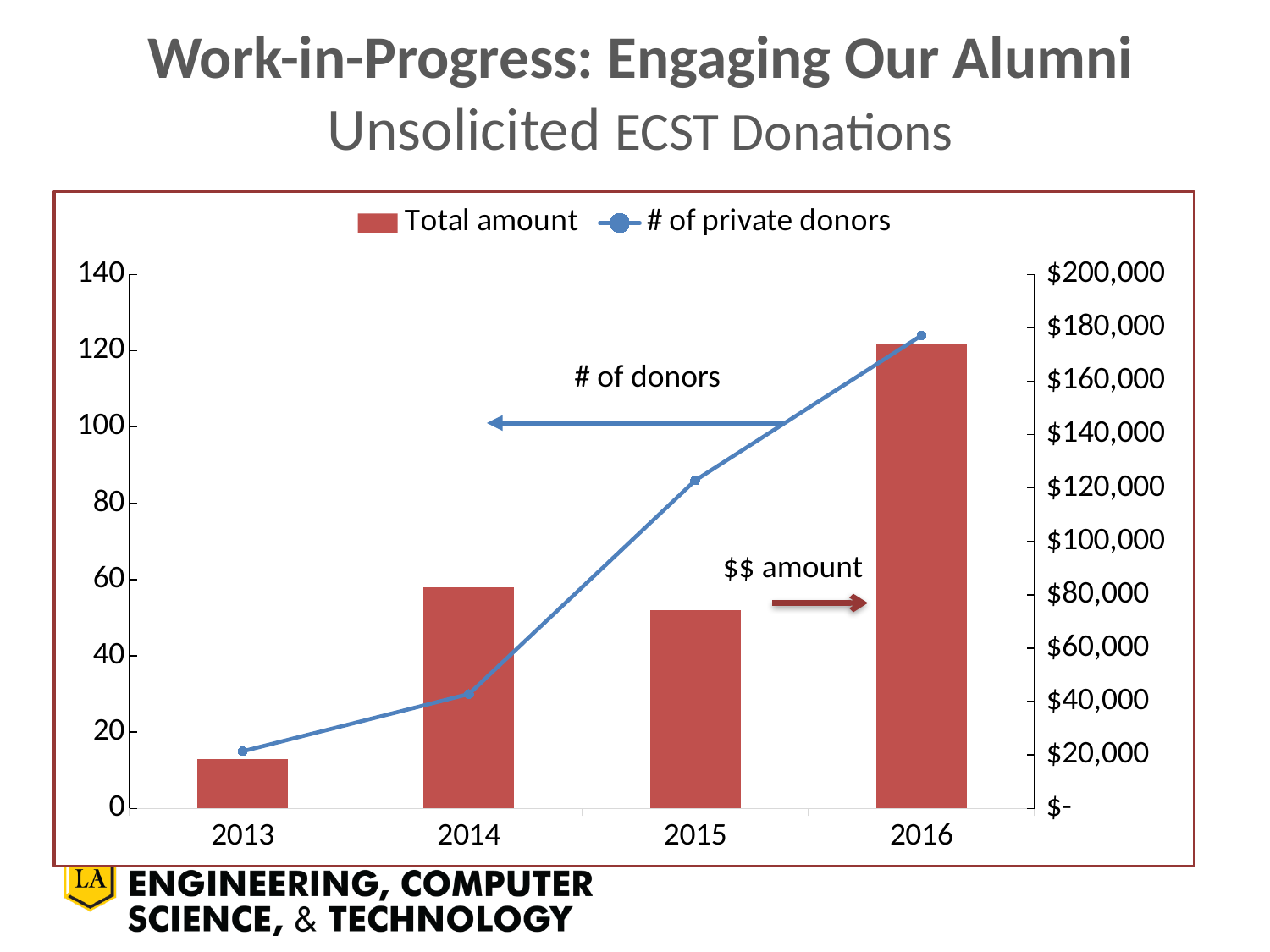
What kind of chart is shown on the slide? A combined bar and line chart How many years are shown on the x axis? 4 Is the total amount for 2013 greater or less than $40,000? less Does the number of private donors rise or fall from 2013 to 2016? rise Which year has the higher total amount, 2014 or 2015? 2014 Is the number of private donors in 2015 greater or less than 80? greater Which year has the lowest total amount bar? 2013 How many series does the legend list? 2 Which year has the highest total amount bar? 2016 Is the total amount for 2016 greater or less than $160,000? greater Which year has the highest number of private donors? 2016